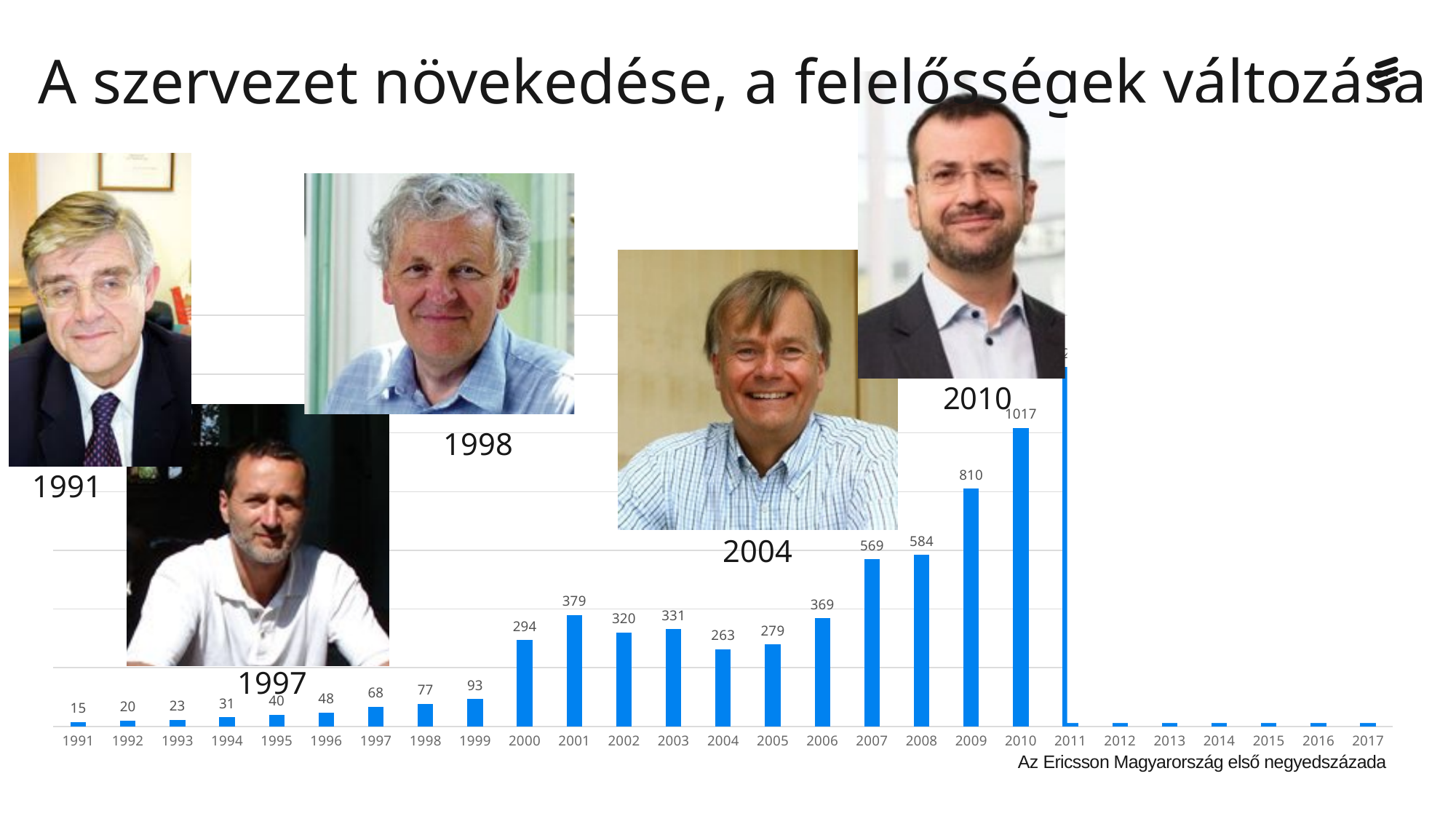
Which year has the tallest bar in the chart? 2011 How many years are shown on the x axis of the chart? 27 Do the values rise or fall from 1991 to 2001? rise What is the value for 2001? 379 What is the difference between the values for 2010 and 2009? 207 What is the value for 2009? 810 What is the value for 2004? 263 Which is larger, the value for 2002 or the value for 2003? 2003 What is the difference between the values for 2008 and 2007? 15 What type of chart is shown on the slide? bar chart What is the value for 2010? 1017 What is the value for 1991? 15